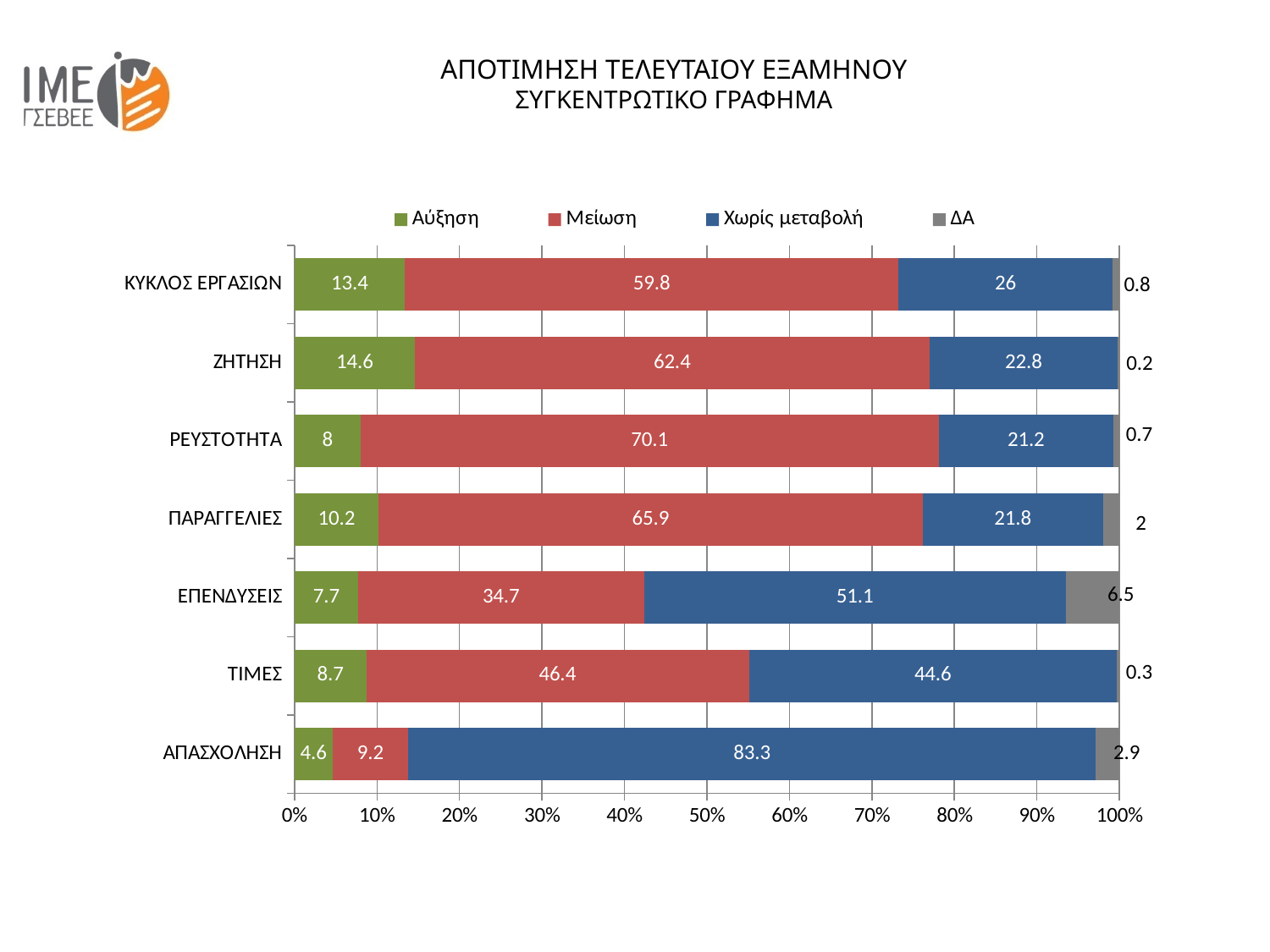
How many categories are shown on the chart? 7 What kind of chart is shown on the slide? Stacked bar chart What colour represents Μείωση in the legend? Red For ΤΙΜΕΣ, which is larger: Μείωση or Χωρίς μεταβολή? Μείωση What is the value of ΔΑ for ΕΠΕΝΔΥΣΕΙΣ? 6.5 Which category has the lowest value for Μείωση? ΑΠΑΣΧΟΛΗΣΗ What is the value of Χωρίς μεταβολή for ΑΠΑΣΧΟΛΗΣΗ? 83.3 What is the total of the stacked bar for ΕΠΕΝΔΥΣΕΙΣ? 100 How many series does the legend list? 4 What is the value of Μείωση for ΡΕΥΣΤΟΤΗΤΑ? 70.1 What is the difference between Μείωση and Αύξηση for ΚΥΚΛΟΣ ΕΡΓΑΣΙΩΝ? 46.4 Which category has the highest value for Αύξηση? ΖΗΤΗΣΗ